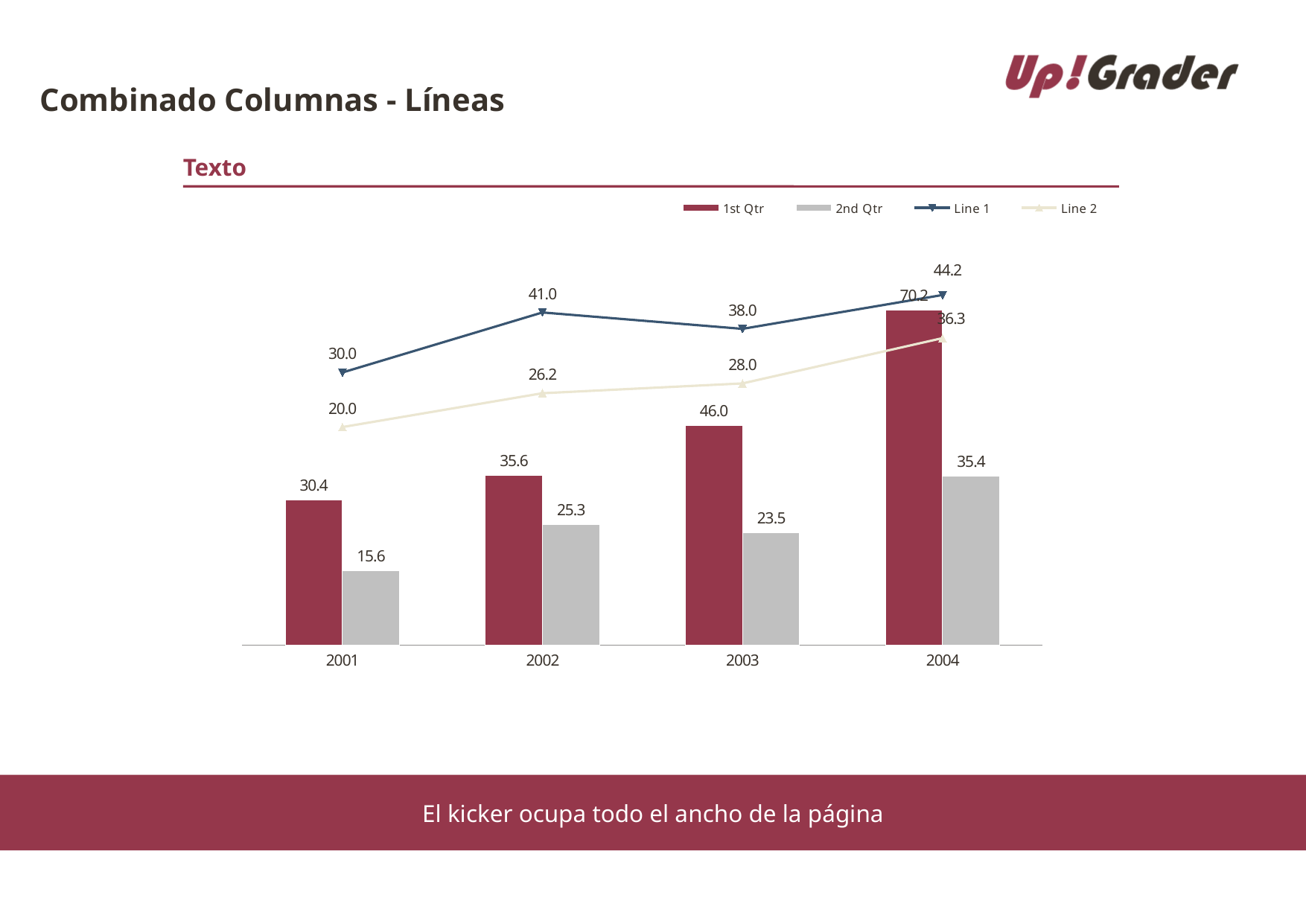
What is the value of 2nd Qtr for 2001? 15.6 Which year has the highest 1st Qtr value? 2004 What is the value of Line 1 for 2002? 41.0 What is the value of 1st Qtr for 2003? 46.0 What is the value of Line 2 for 2003? 28.0 What is the difference between the 1st Qtr and 2nd Qtr values for 2004? 34.8 What kind of chart is shown on the slide? Combined bar and line chart Which is larger for 2003: the Line 1 value or the 1st Qtr value? 1st Qtr Which year has the lowest 2nd Qtr value? 2001 Does the Line 2 series rise or fall from 2001 to 2004? Rise How many years are shown on the x axis? 4 How many series does the legend list? 4